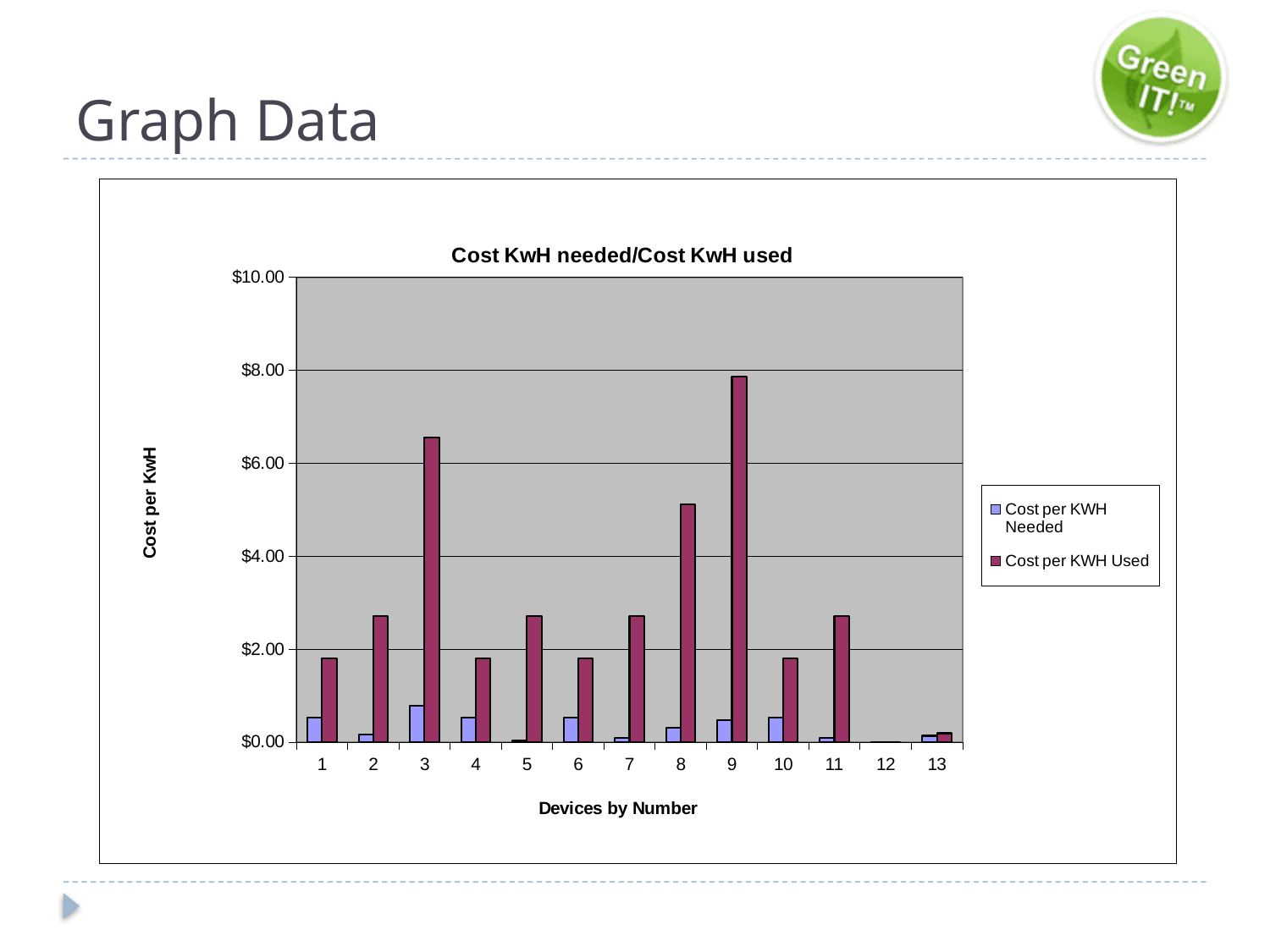
What is the label on the x axis of the chart? Devices by Number Which device has the lowest Cost per KWH Used? 12 How many devices are shown along the x axis? 13 Is the Cost per KWH Used for device 1 greater or less than $2.00? less How many series does the legend list? 2 Which device has the highest Cost per KWH Used? 9 Which device has the highest Cost per KWH Needed? 3 Is the Cost per KWH Used for device 9 greater or less than $6.00? greater Is the Cost per KWH Used for device 8 greater or less than $4.00? greater What is the title of the chart? Cost KwH needed/Cost KwH used Which is larger, the Cost per KWH Used for device 3 or for device 8? device 3 What kind of chart is shown on the slide? bar chart